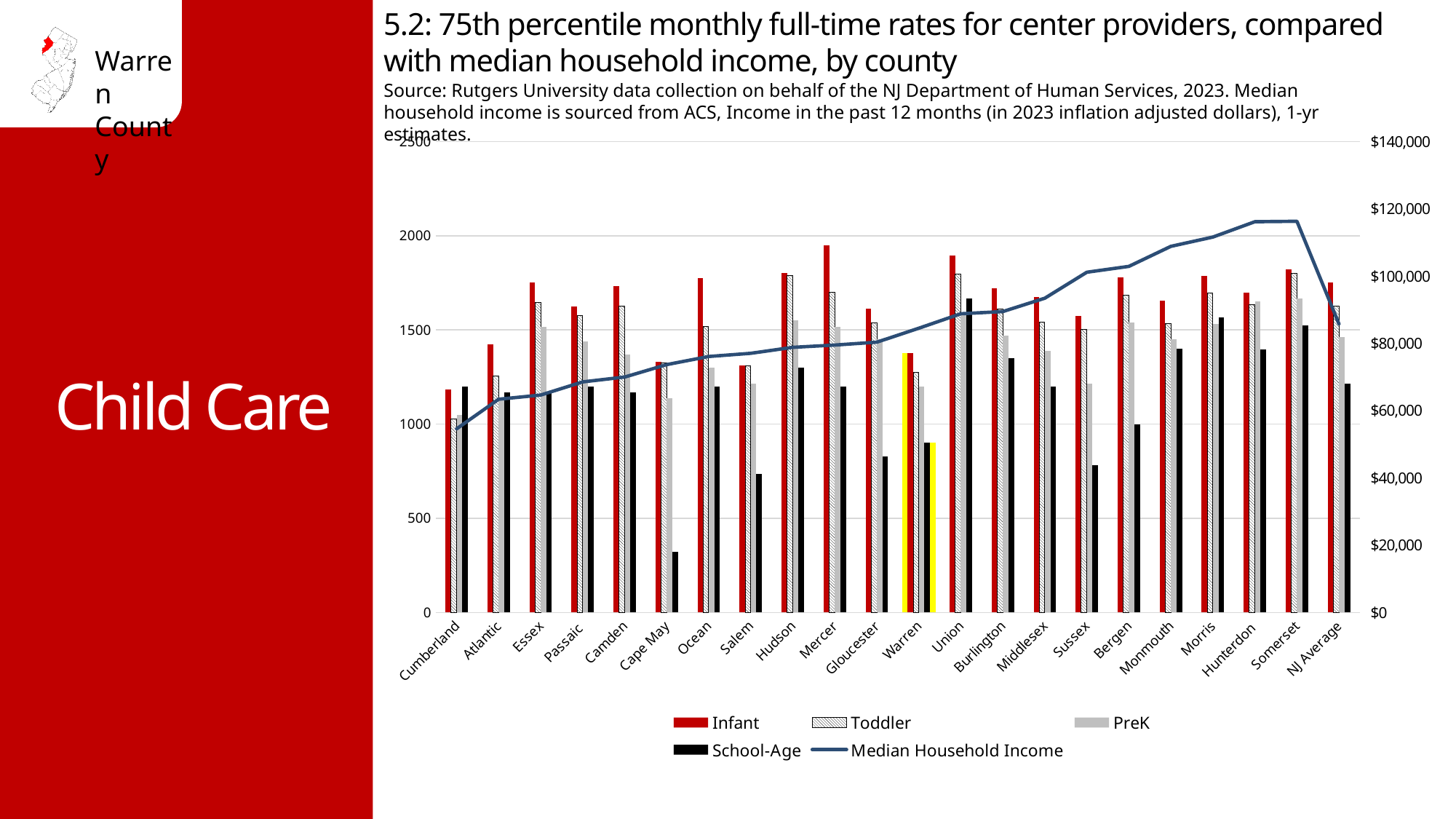
Which county has the lowest School-Age rate? Cape May Is the Infant rate for Warren greater or less than 1500? less Which county's bars are outlined in yellow? Warren Which is larger for Warren, the Infant rate or the School-Age rate? Infant How many counties/categories are shown along the x axis? 22 How many series does the legend list? 5 Is the Infant rate for Cumberland greater or less than 1000? greater Which county has the highest Infant rate? Mercer What kind of chart is shown on the slide? bar chart with a line Is the Median Household Income for Somerset greater or less than $100,000? greater Which county has the lowest Infant rate? Cumberland